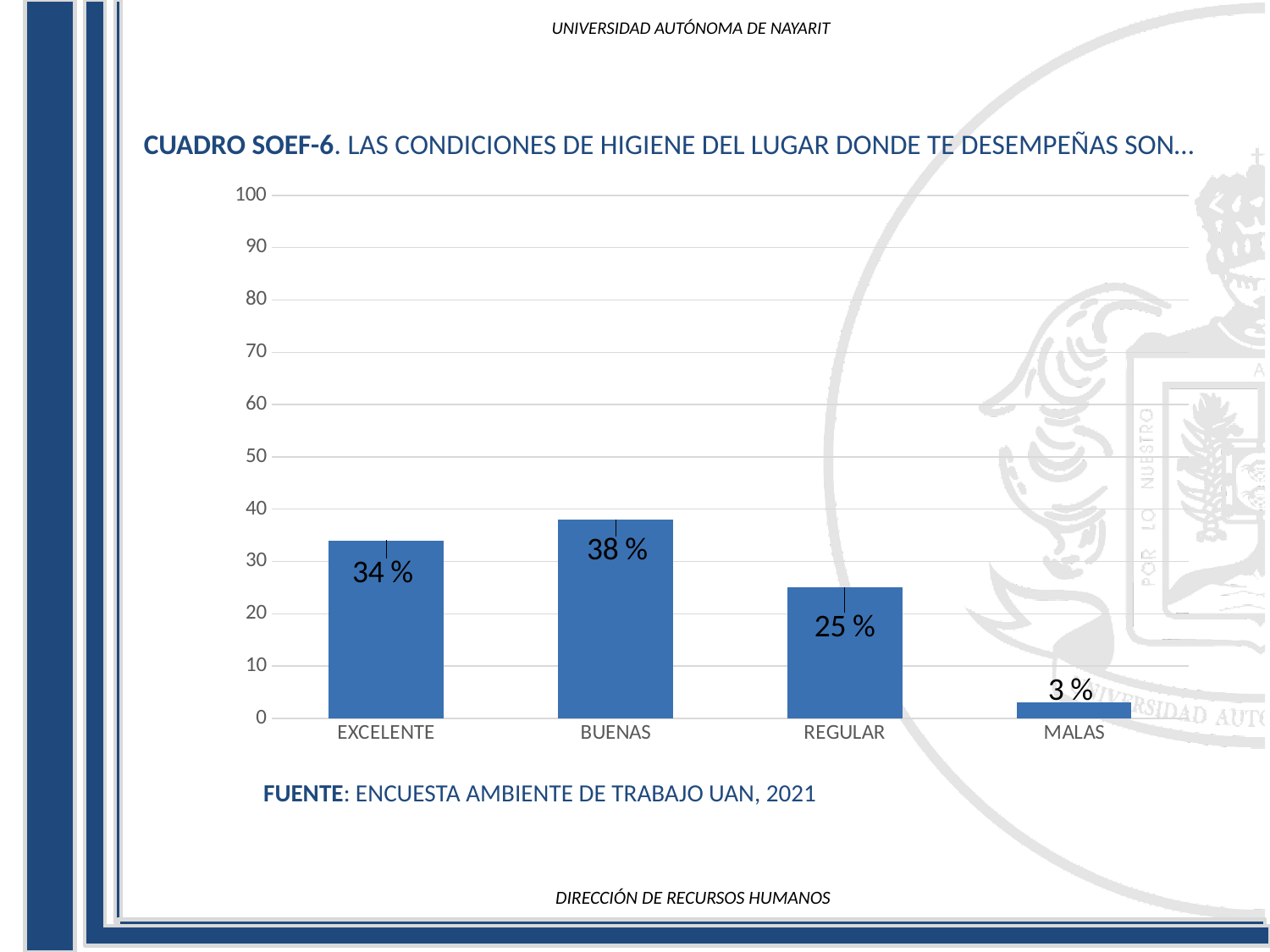
Which is larger, the value for EXCELENTE or the value for REGULAR? EXCELENTE What is the difference between the values for REGULAR and MALAS? 22 % What kind of chart is shown on the slide? bar chart Which category has the highest value? BUENAS What is the difference between the values for BUENAS and EXCELENTE? 4 % What is the value for MALAS? 3 % How many categories are shown on the x axis? 4 What is the value for REGULAR? 25 % Is the value for REGULAR greater or less than 30? less What is the value for BUENAS? 38 % What is the value for EXCELENTE? 34 % Which category has the lowest value? MALAS